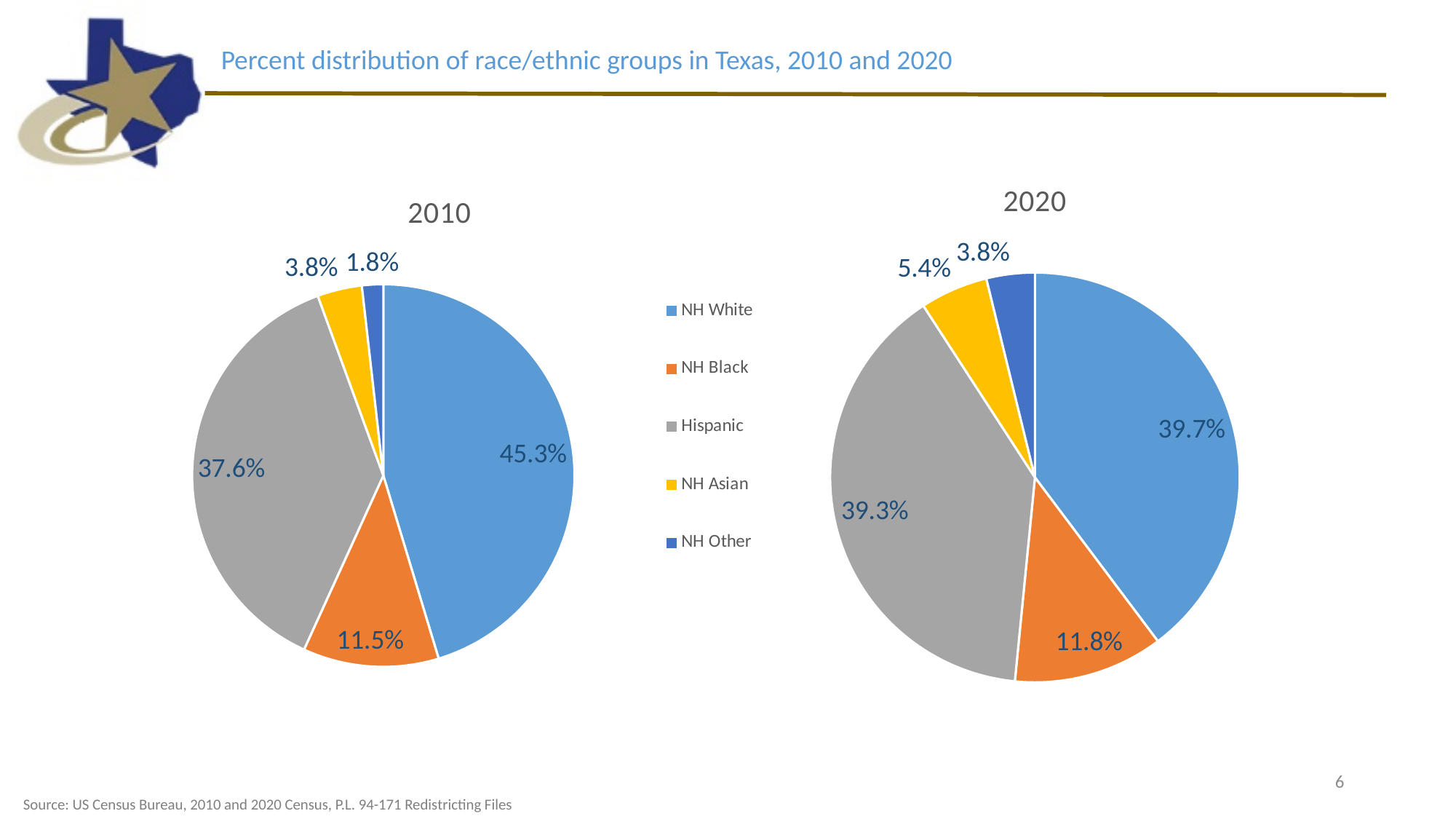
In the 2020 pie chart, which is larger, the NH White share or the Hispanic share? NH White In the 2010 pie chart, what percentage is shown for NH Other? 1.8% In the 2010 pie chart, which group has the smallest share? NH Other In the 2020 pie chart, which group has the smallest share? NH Other What is the title of the slide? Percent distribution of race/ethnic groups in Texas, 2010 and 2020 What kind of charts are shown on the slide? Pie charts In the 2020 pie chart, what percentage is shown for NH Asian? 5.4% In the 2010 pie chart, what percentage is shown for NH White? 45.3% What is the difference between the NH White share in 2010 and in 2020? 5.6% In the 2020 pie chart, what percentage is shown for Hispanic? 39.3% In the 2010 pie chart, which group has the largest share? NH White How many groups does the legend list? 5